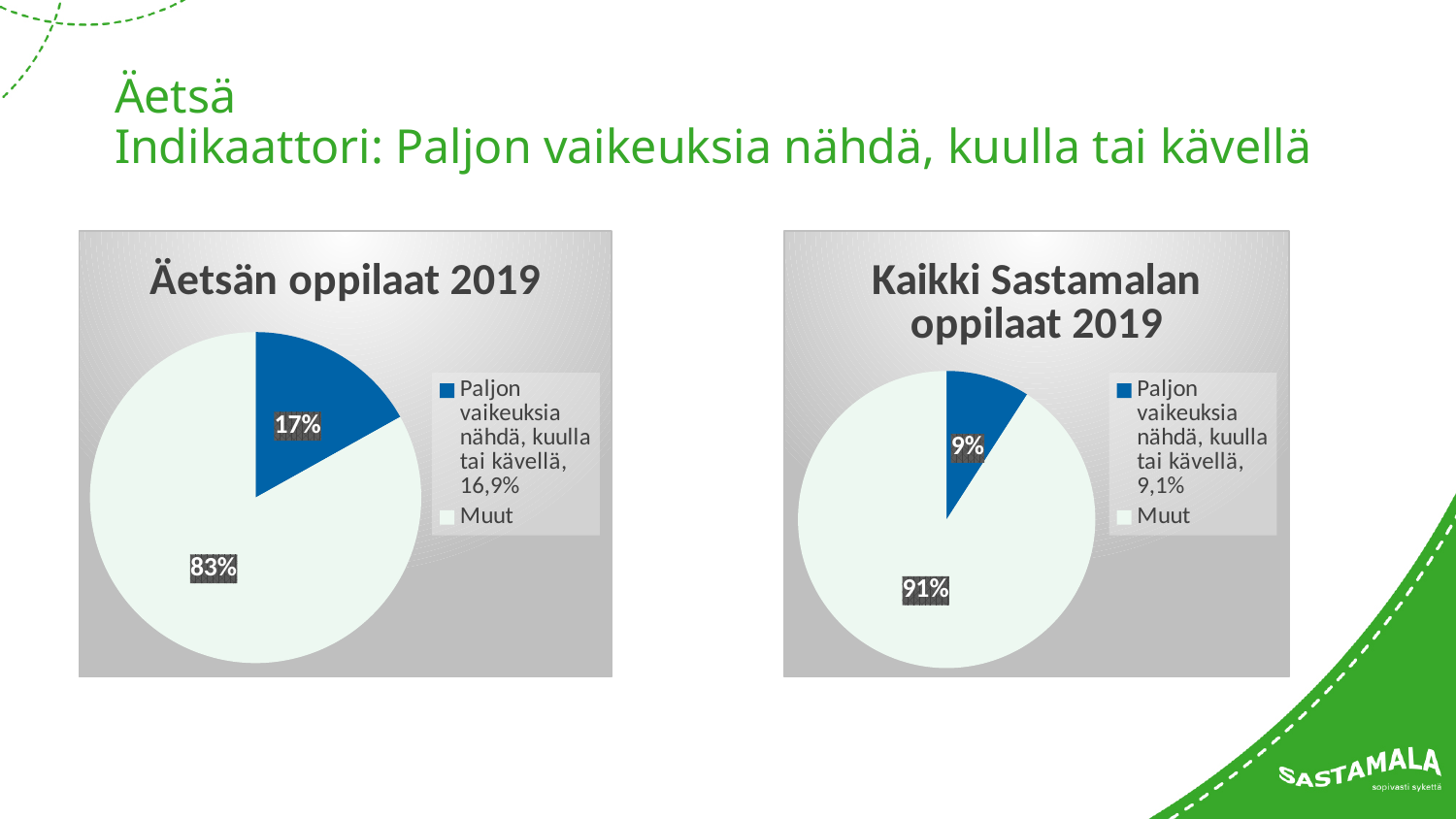
In the 'Kaikki Sastamalan oppilaat 2019' chart, which slice is the largest? Muut What type of chart is the 'Äetsän oppilaat 2019' chart? Pie chart Which chart shows a larger share for 'Paljon vaikeuksia nähdä, kuulla tai kävellä', 'Äetsän oppilaat 2019' or 'Kaikki Sastamalan oppilaat 2019'? Äetsän oppilaat 2019 In the 'Kaikki Sastamalan oppilaat 2019' chart, what percentage is shown for the 'Muut' slice? 91% In the 'Äetsän oppilaat 2019' chart, which slice is the smallest? Paljon vaikeuksia nähdä, kuulla tai kävellä In the 'Kaikki Sastamalan oppilaat 2019' chart, what percentage is shown for the 'Paljon vaikeuksia nähdä, kuulla tai kävellä' slice? 9% How many slices does the 'Kaikki Sastamalan oppilaat 2019' pie chart have? 2 In the 'Äetsän oppilaat 2019' chart, what percentage is shown for the 'Paljon vaikeuksia nähdä, kuulla tai kävellä' slice? 17% In the 'Äetsän oppilaat 2019' chart, what percentage is shown for the 'Muut' slice? 83% In the 'Äetsän oppilaat 2019' chart, what colour is the 'Paljon vaikeuksia nähdä, kuulla tai kävellä' slice? Blue In the 'Kaikki Sastamalan oppilaat 2019' chart, what exact percentage is given in the legend for 'Paljon vaikeuksia nähdä, kuulla tai kävellä'? 9,1% In the 'Äetsän oppilaat 2019' chart, what is the difference between the 'Muut' slice and the 'Paljon vaikeuksia nähdä, kuulla tai kävellä' slice? 66%